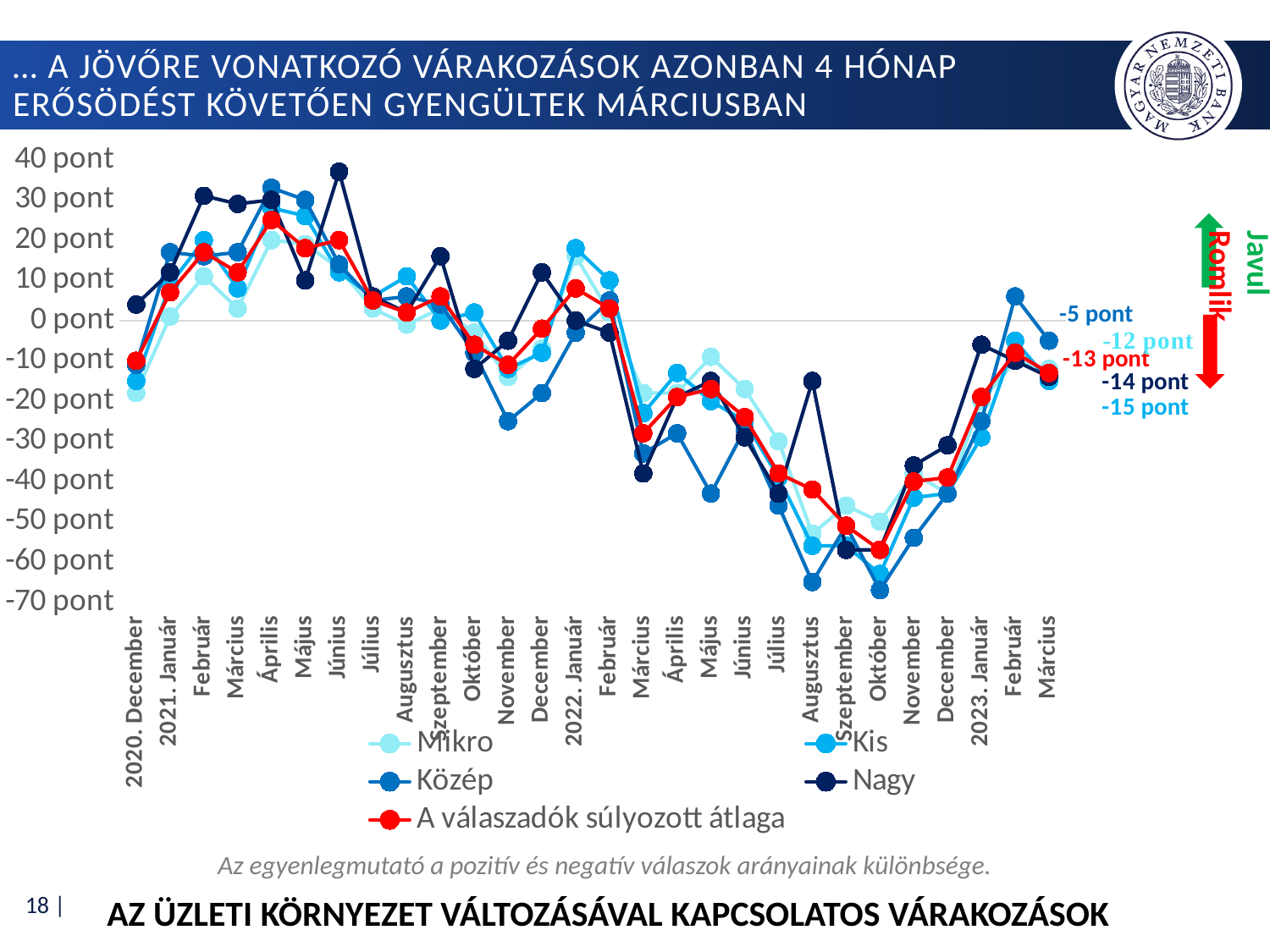
What is the difference between the Közép and Kis values in 2023 March? 10 pont How many months are shown on the x axis? 28 What is the value of 'A válaszadók súlyozott átlaga' in 2023 March? -13 pont Is the value for Nagy in 2021 Június greater or less than 30 pont? greater Which series has the highest value in 2023 March? Közép Which series has the lowest value in 2023 March? Kis How many series does the legend list? 5 What kind of chart is shown on the slide? line chart What is the value of the Nagy series in 2023 March? -14 pont What is the value of the Közép series in 2023 March? -5 pont What is the value of the Kis series in 2023 March? -15 pont What is the value of the Mikro series in 2023 March? -12 pont